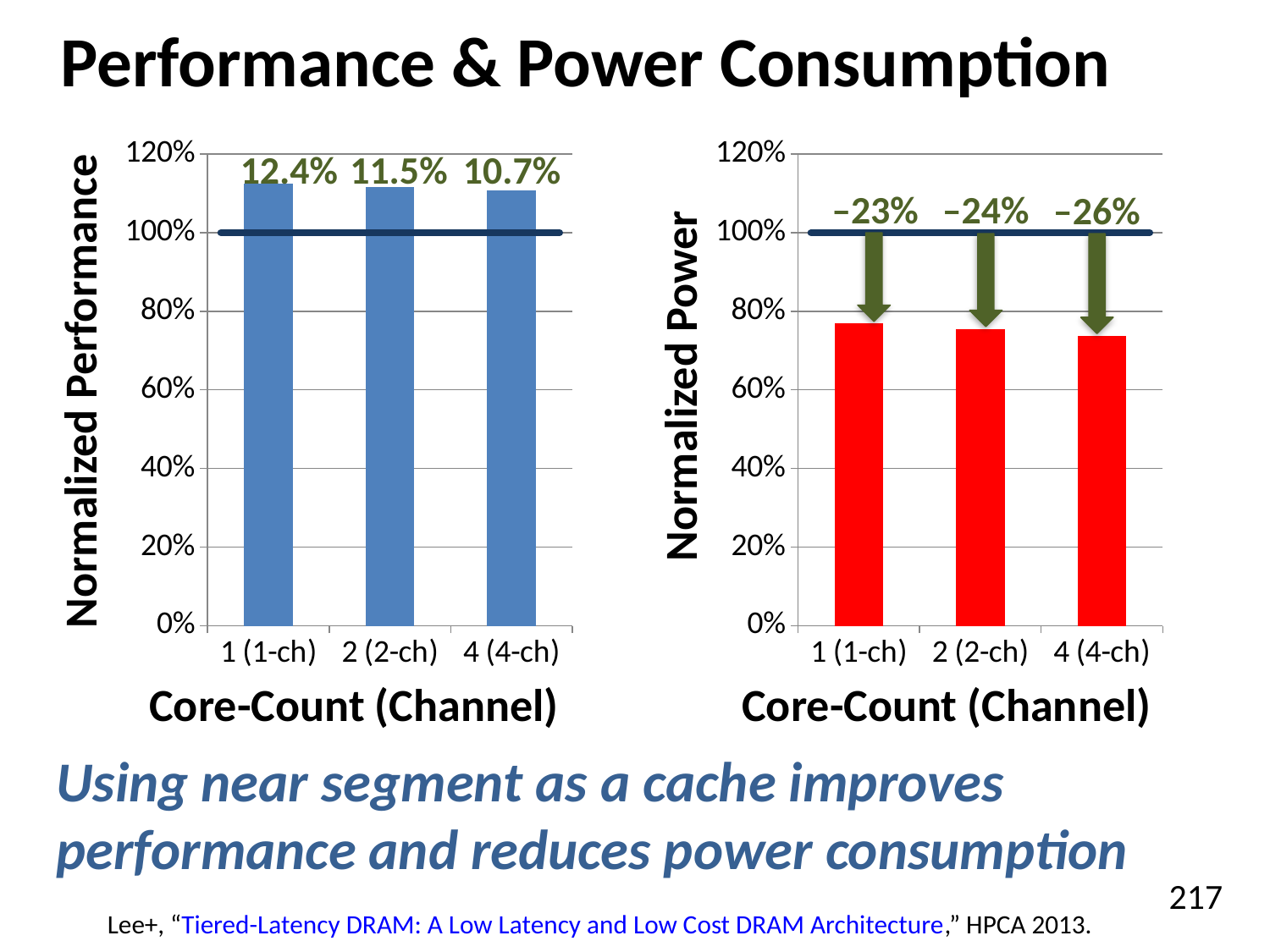
How many categories are shown on the x axis of the Normalized Performance chart? 3 On the Normalized Power chart, which category has the lowest bar? 4 (4-ch) On the Normalized Performance chart, do the bar values rise or fall as core count increases along the x axis? fall On the Normalized Performance chart, is the value for 2 (2-ch) greater or less than 100%? greater On the Normalized Power chart, is the value for 4 (4-ch) greater or less than 60%? greater What kind of chart is the Normalized Power chart? bar chart On the Normalized Performance chart, what percentage label is shown above the bar for 4 (4-ch)? 10.7% On the Normalized Performance chart, what percentage label is shown above the bar for 1 (1-ch)? 12.4% On the Normalized Power chart, what percentage label is shown above the bar for 4 (4-ch)? –26% On the Normalized Power chart, what percentage label is shown above the bar for 2 (2-ch)? –24% On the Normalized Power chart, is the value for 1 (1-ch) greater or less than 80%? less On the Normalized Performance chart, which category has the highest bar? 1 (1-ch)